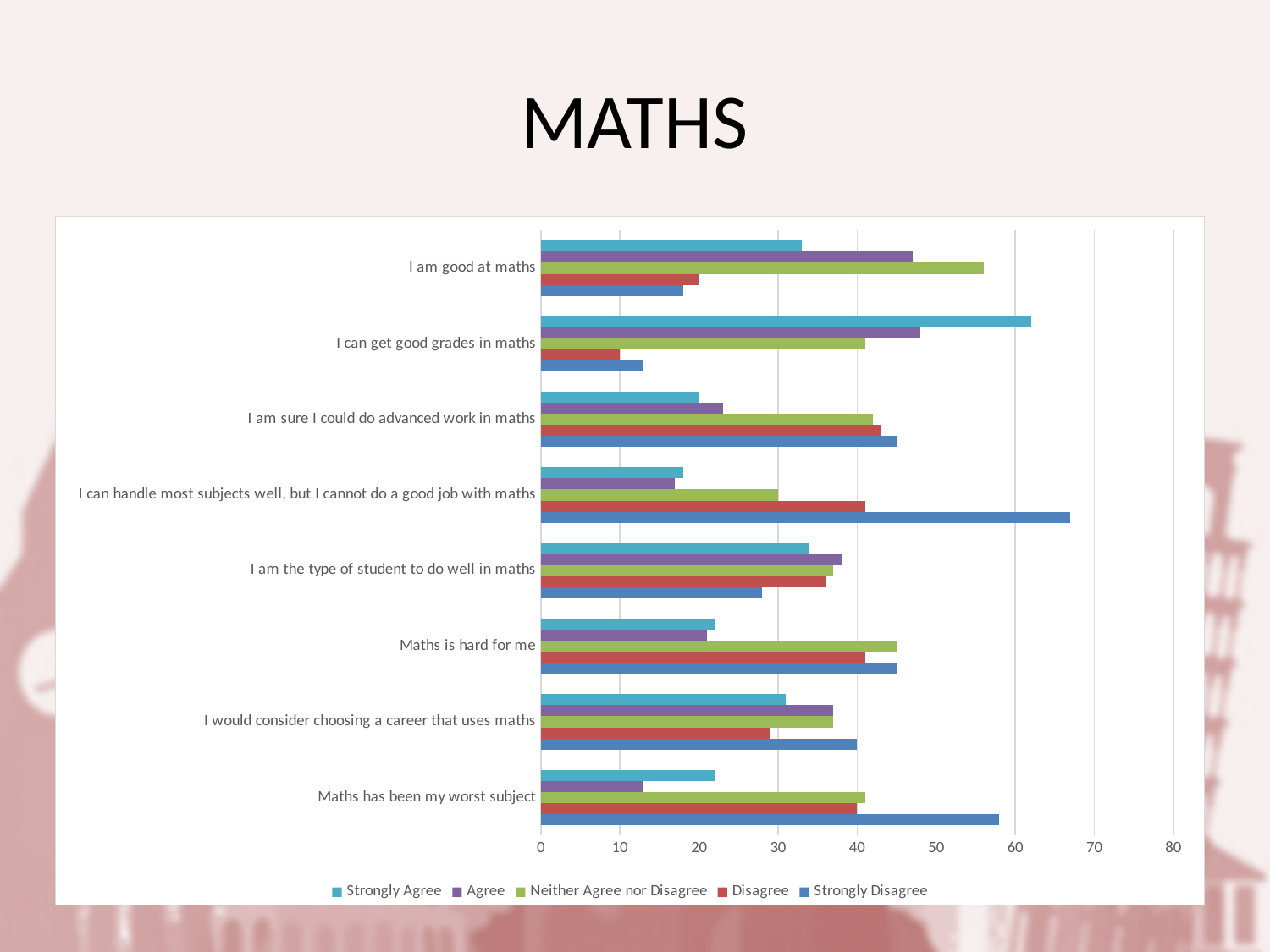
How many statements (categories) are plotted on the chart? 8 What is the title of the slide containing the chart? MATHS Is the Strongly Disagree value for "I can handle most subjects well, but I cannot do a good job with maths" greater or less than 60? greater Is the Neither Agree nor Disagree value for "I am good at maths" greater or less than 50? greater Is the Strongly Agree value for "I can get good grades in maths" greater or less than 50? greater How many series does the legend list? 5 For "I am good at maths", which is larger: Neither Agree nor Disagree or Disagree? Neither Agree nor Disagree Which statement has the longest Strongly Agree bar? I can get good grades in maths What kind of chart is shown on the slide? bar chart For "Maths has been my worst subject", which series has the shortest bar? Agree Which statement has the longest Strongly Disagree bar? I can handle most subjects well, but I cannot do a good job with maths